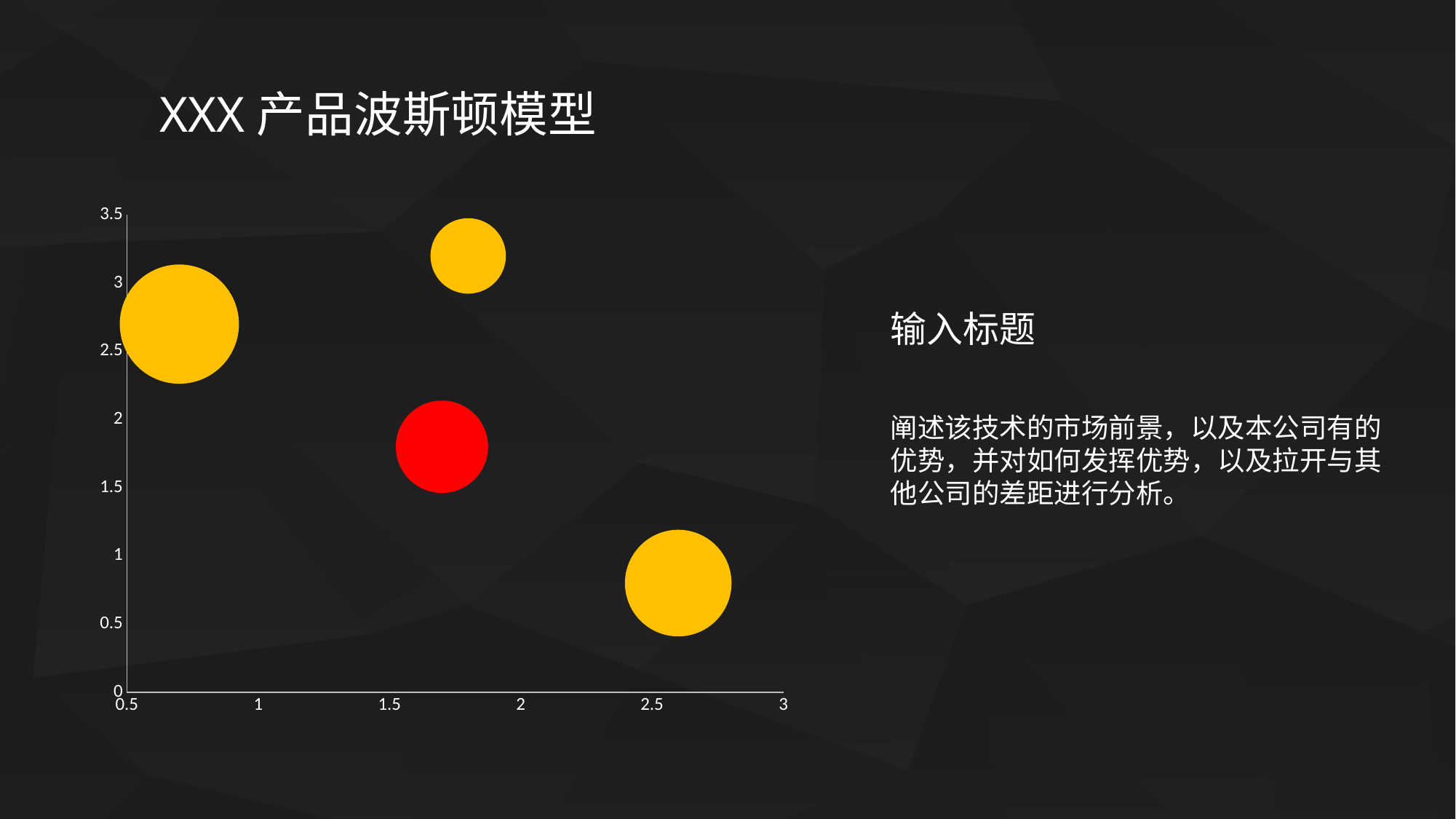
Is the x-axis value of the red bubble greater or less than 1.5? greater How many bubbles are plotted on the chart? 4 What is the title of the slide containing the chart? XXX 产品波斯顿模型 What kind of chart is shown on the slide? Bubble chart Is the y-axis value of the rightmost bubble greater or less than 1? less Is the y-axis value of the leftmost bubble greater or less than 2.5? greater Which has the higher y-axis value, the red bubble or the rightmost yellow bubble? The red bubble How many of the bubbles on the chart are red? 1 Which bubble has the lowest y-axis value? The rightmost yellow bubble